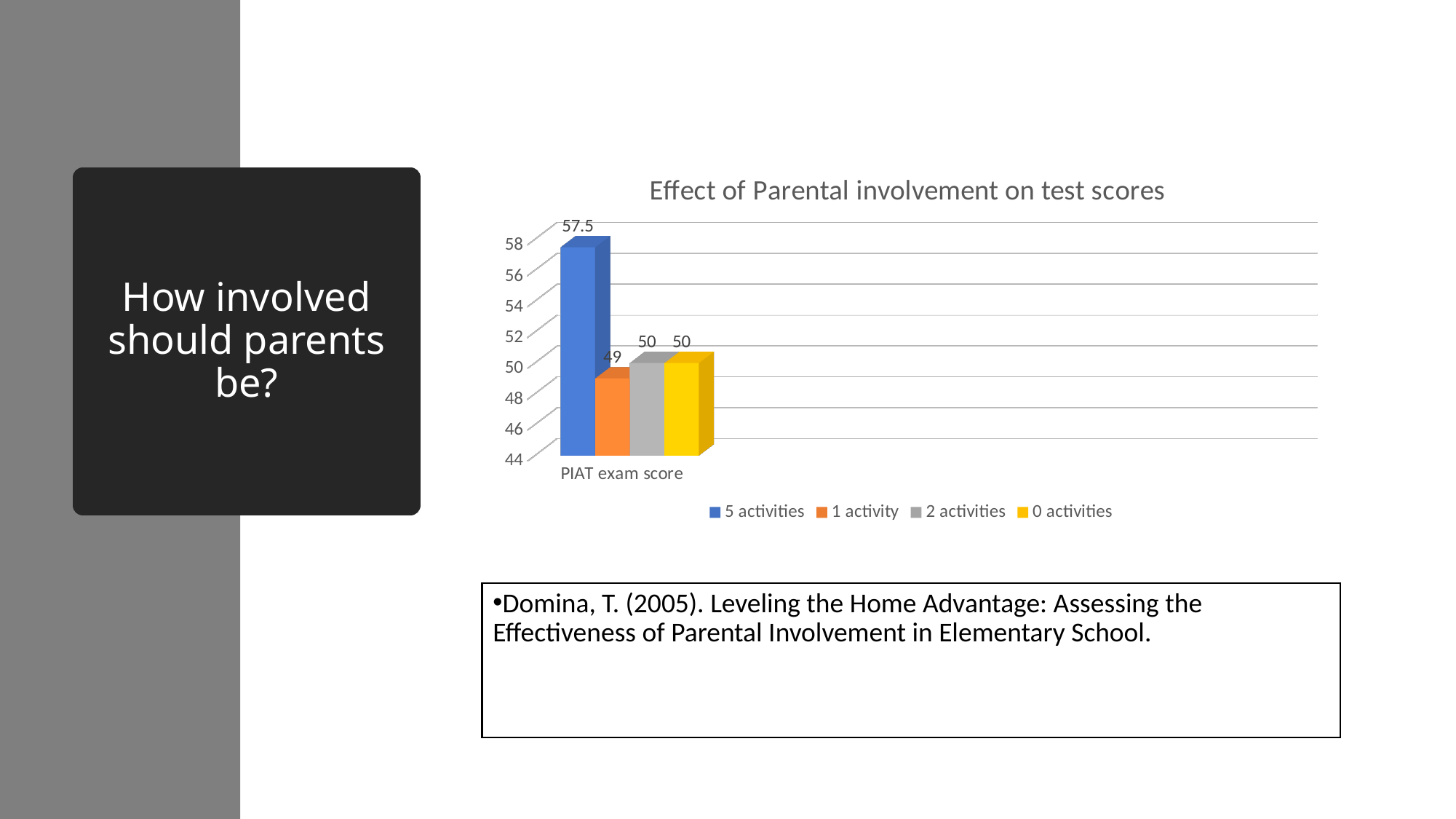
Is the PIAT exam score for 1 activity greater or less than 52? less Which series has the highest PIAT exam score? 5 activities Which series has the lowest PIAT exam score? 1 activity What is the PIAT exam score for 2 activities? 50 How many series does the legend list? 4 What is the PIAT exam score for 5 activities? 57.5 What is the PIAT exam score for 0 activities? 50 What kind of chart is shown on the slide? bar chart What is the title of the chart? Effect of Parental involvement on test scores What is the difference between the PIAT exam score for 5 activities and for 1 activity? 8.5 What is the PIAT exam score for 1 activity? 49 Which is larger, the PIAT exam score for 5 activities or for 2 activities? 5 activities